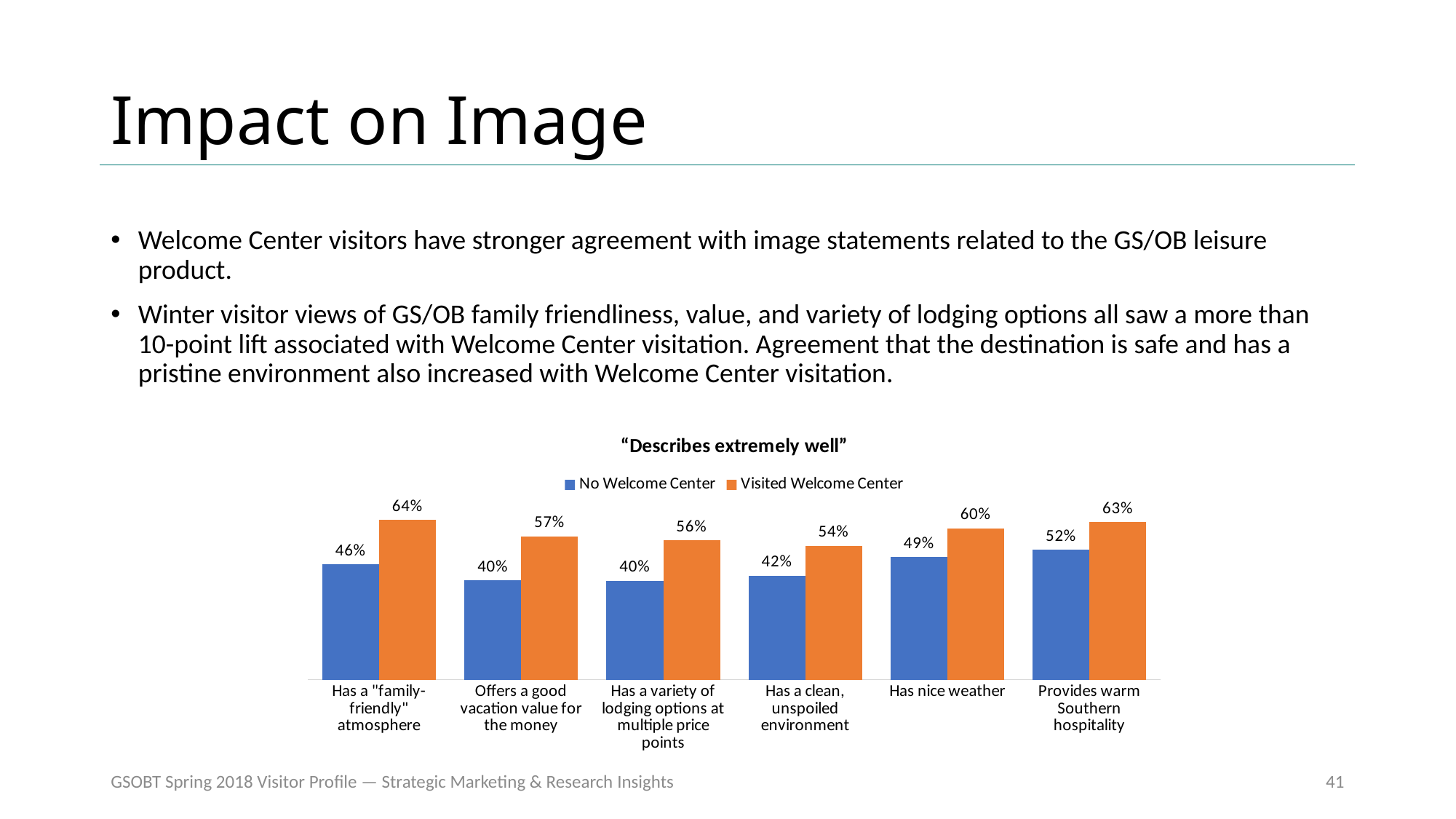
How many categories are shown on the x axis of the chart? 6 Which category has the lowest "Visited Welcome Center" value? Has a clean, unspoiled environment What is the title of the chart? "Describes extremely well" What is the "Visited Welcome Center" value for "Has a "family-friendly" atmosphere"? 64% What is the difference between the "Visited Welcome Center" and "No Welcome Center" values for "Offers a good vacation value for the money"? 17 percentage points What is the "Visited Welcome Center" value for "Has a clean, unspoiled environment"? 54% What is the "No Welcome Center" value for "Has nice weather"? 49% What kind of chart is shown on the slide? Bar chart Which is larger: the "Visited Welcome Center" value for "Has nice weather" or for "Provides warm Southern hospitality"? Provides warm Southern hospitality How many series does the legend list? 2 Which colour represents the "Visited Welcome Center" series? Orange Which category has the highest "No Welcome Center" value? Provides warm Southern hospitality